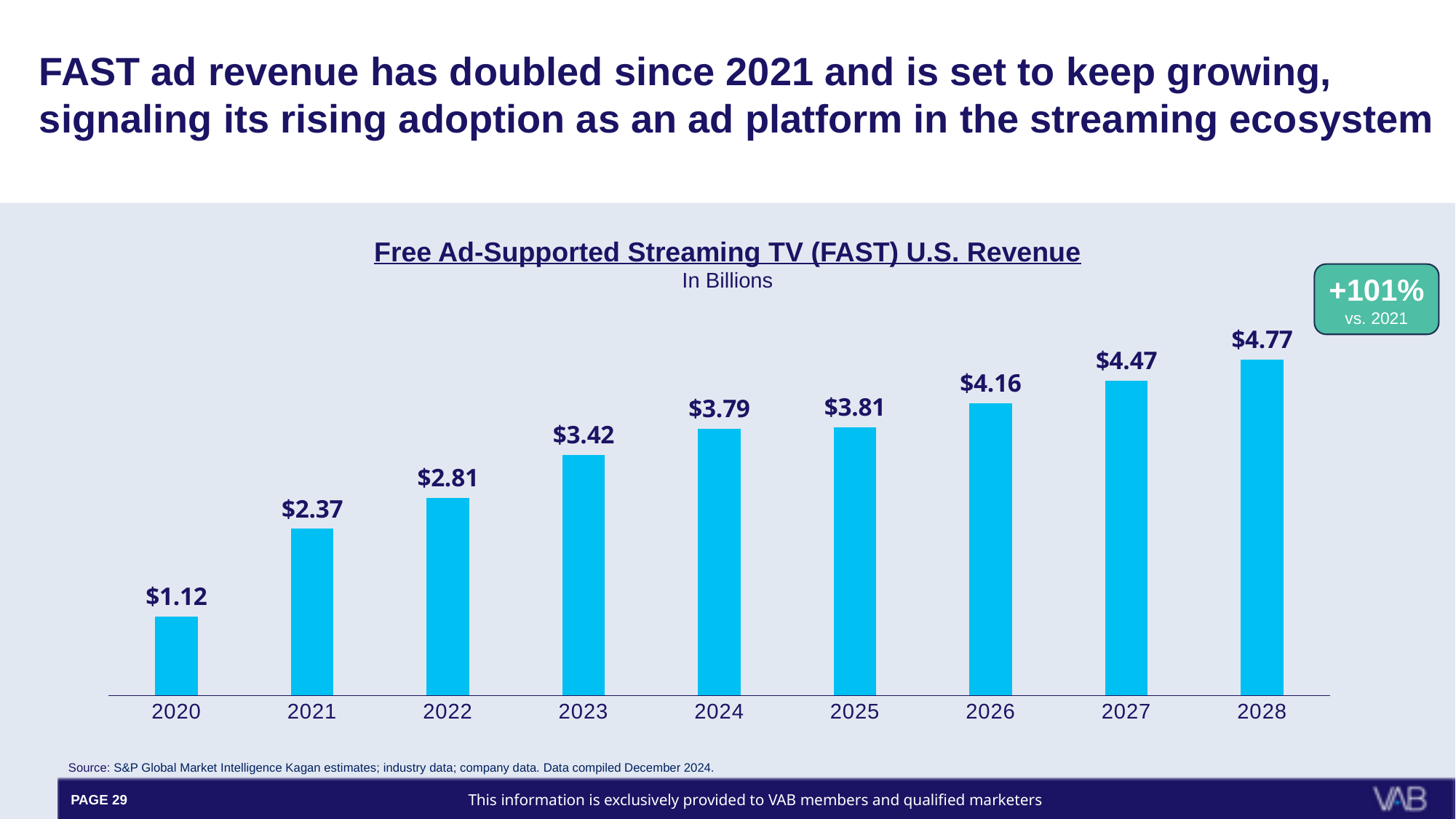
What unit is the chart's revenue expressed in, according to the subtitle? In Billions What is the FAST U.S. revenue value shown for 2020? $1.12 Which year has the highest FAST U.S. revenue value? 2028 Which year has the lowest FAST U.S. revenue value? 2020 What is the FAST U.S. revenue value shown for 2024? $3.79 What is the difference between the 2028 value and the 2021 value? $2.40 How many years are shown on the x axis of the chart? 9 Do the FAST U.S. revenue values rise or fall from 2020 to 2028? Rise Which year has the larger value, 2022 or 2026? 2026 What is the FAST U.S. revenue value shown for 2028? $4.77 What is the difference between the 2023 value and the 2022 value? $0.61 What kind of chart is used to show FAST U.S. revenue? Bar chart